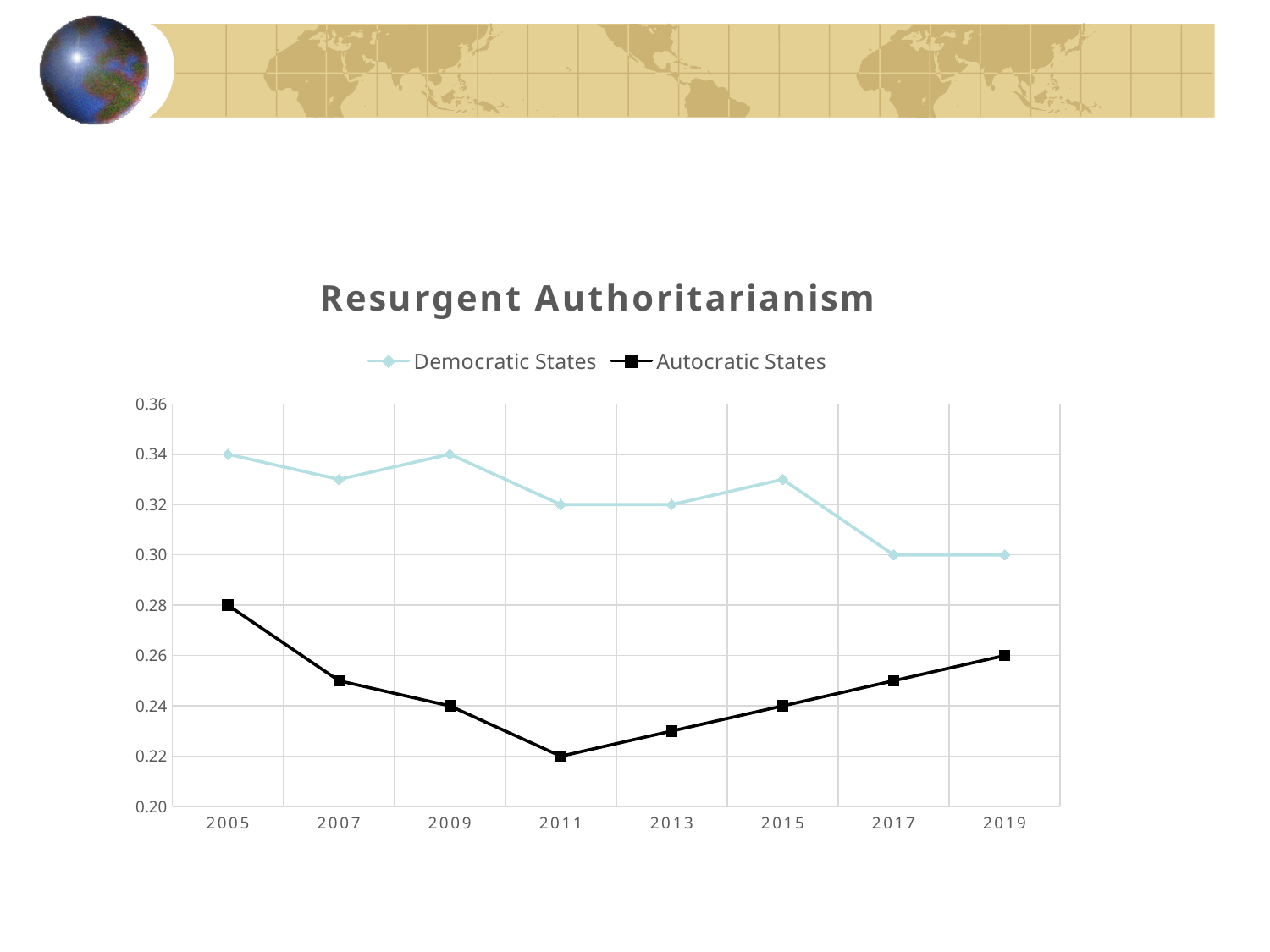
What is the difference between the Autocratic States value in 2005 and in 2011? 0.06 In which year is the Autocratic States value highest? 2005 How many series does the legend list? 2 What kind of chart is shown on the slide? line chart What is the title of the chart? Resurgent Authoritarianism In which year is the Autocratic States value lowest? 2011 Is the value for Democratic States in 2007 greater or less than 0.32? greater What is the value for Democratic States in 2005? 0.34 What is the value for Autocratic States in 2011? 0.22 How many years are plotted along the x axis? 8 In 2019, which series has the larger value, Democratic States or Autocratic States? Democratic States Does the Democratic States line generally rise or fall from 2005 to 2019? fall